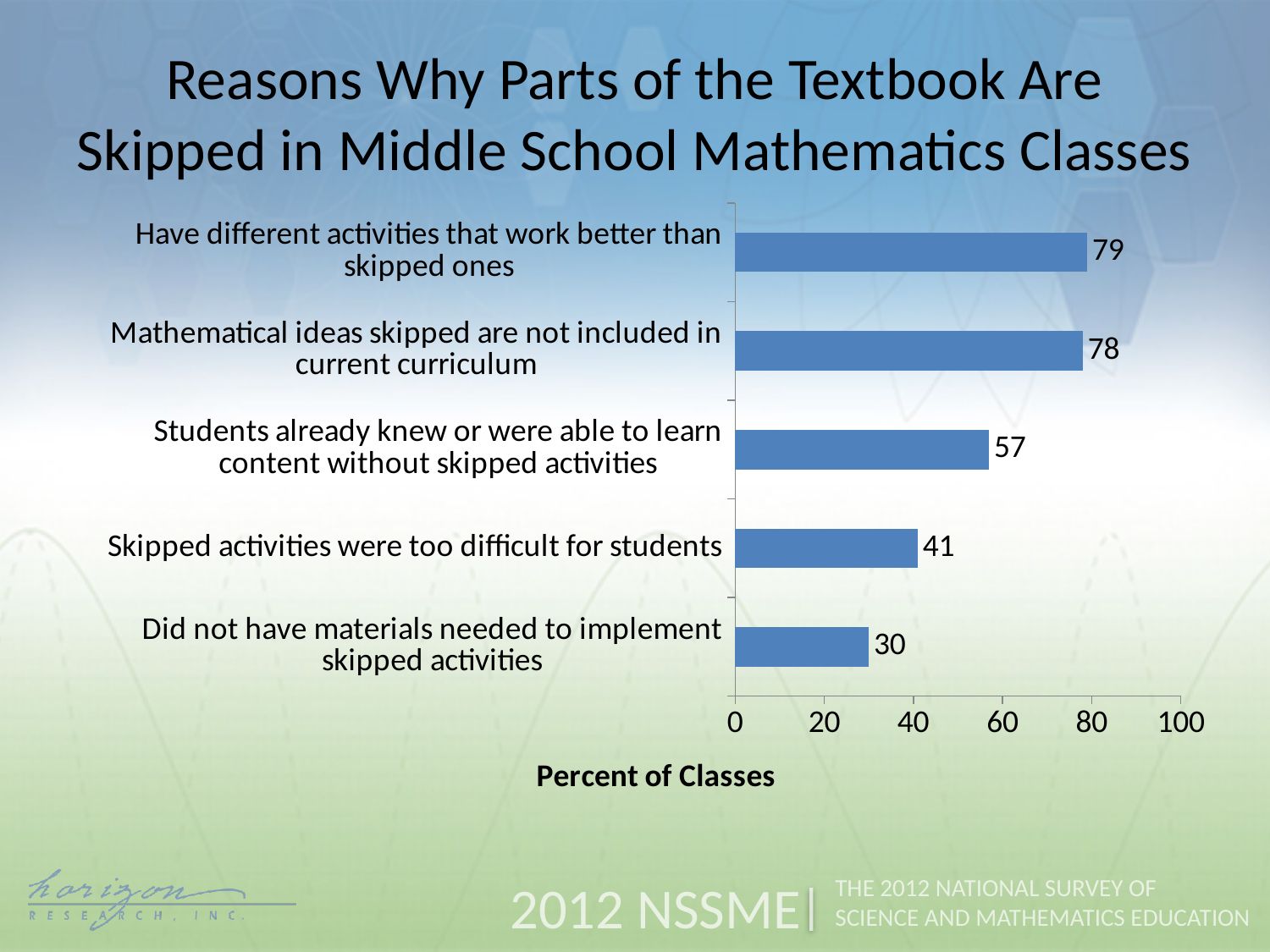
What kind of chart is shown on the slide? Bar chart What is the difference between the values for 'Students already knew or were able to learn content without skipped activities' and 'Skipped activities were too difficult for students'? 16 Which reason has the lowest percent of classes? Did not have materials needed to implement skipped activities Which is larger: the value for 'Mathematical ideas skipped are not included in current curriculum' or the value for 'Students already knew or were able to learn content without skipped activities'? Mathematical ideas skipped are not included in current curriculum Which reason has the highest percent of classes? Have different activities that work better than skipped ones What is the value for 'Skipped activities were too difficult for students'? 41 What is the value for 'Did not have materials needed to implement skipped activities'? 30 What is the difference between the highest and lowest values in the chart? 49 Is the value for 'Skipped activities were too difficult for students' greater or less than 60? less How many reasons (categories) are shown in the chart? 5 What percent of classes skipped parts of the textbook because they have different activities that work better than skipped ones? 79 What is the label of the horizontal axis? Percent of Classes